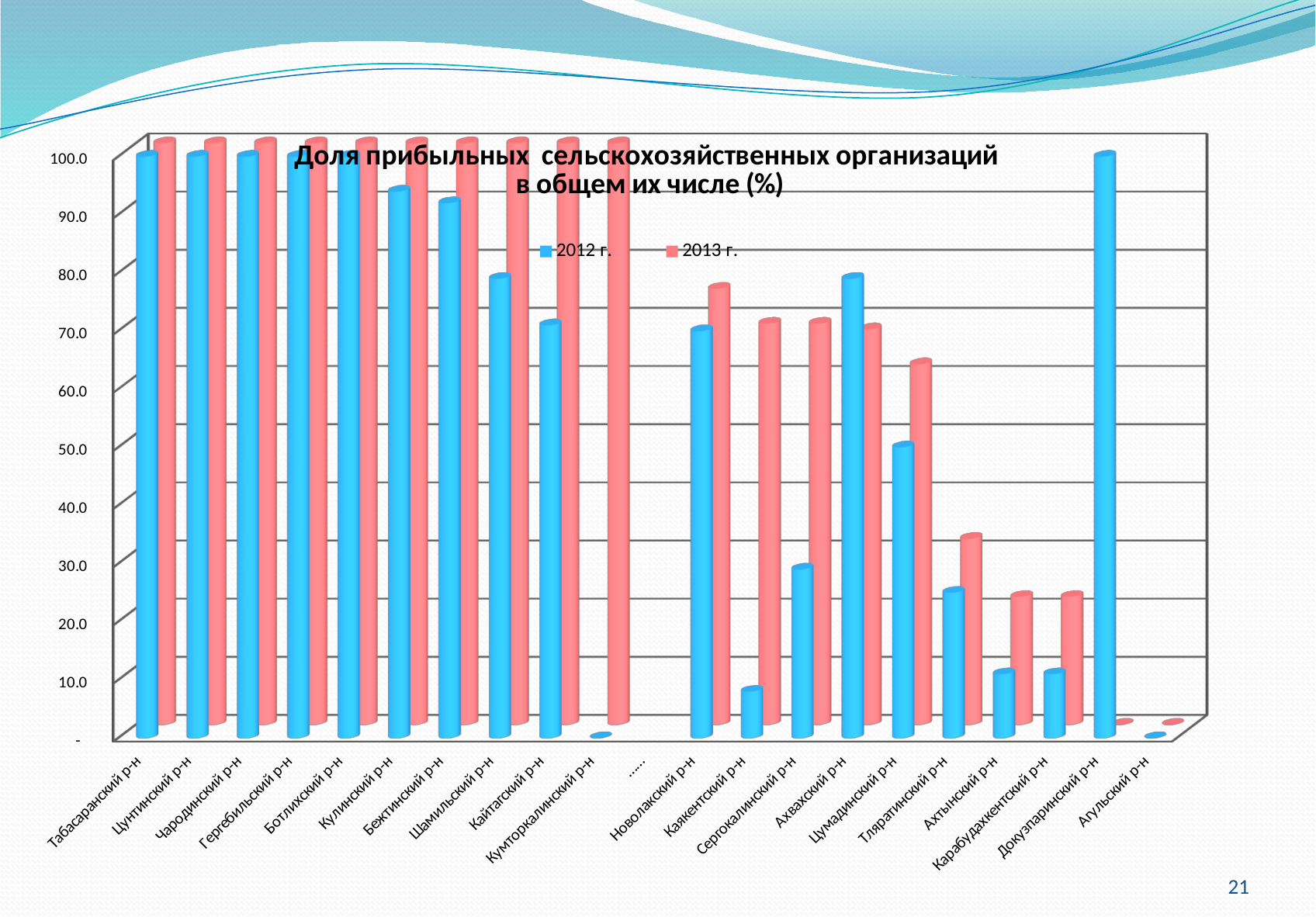
What kind of chart is shown on the slide? bar chart Is the 2012 г. value for Каякентский р-н greater or less than 10? less Is the 2012 г. value for Ахвахский р-н greater or less than 70? greater Is the 2013 г. value for Цумадинский р-н greater or less than 60? greater What are the two series shown in the legend? 2012 г. and 2013 г. How many series does the legend list? 2 What is the title of the chart? Доля прибыльных сельскохозяйственных организаций в общем их числе (%) For Каякентский р-н, which series has the larger value, 2012 г. or 2013 г.? 2013 г. For Ахвахский р-н, which series has the larger value, 2012 г. or 2013 г.? 2012 г.